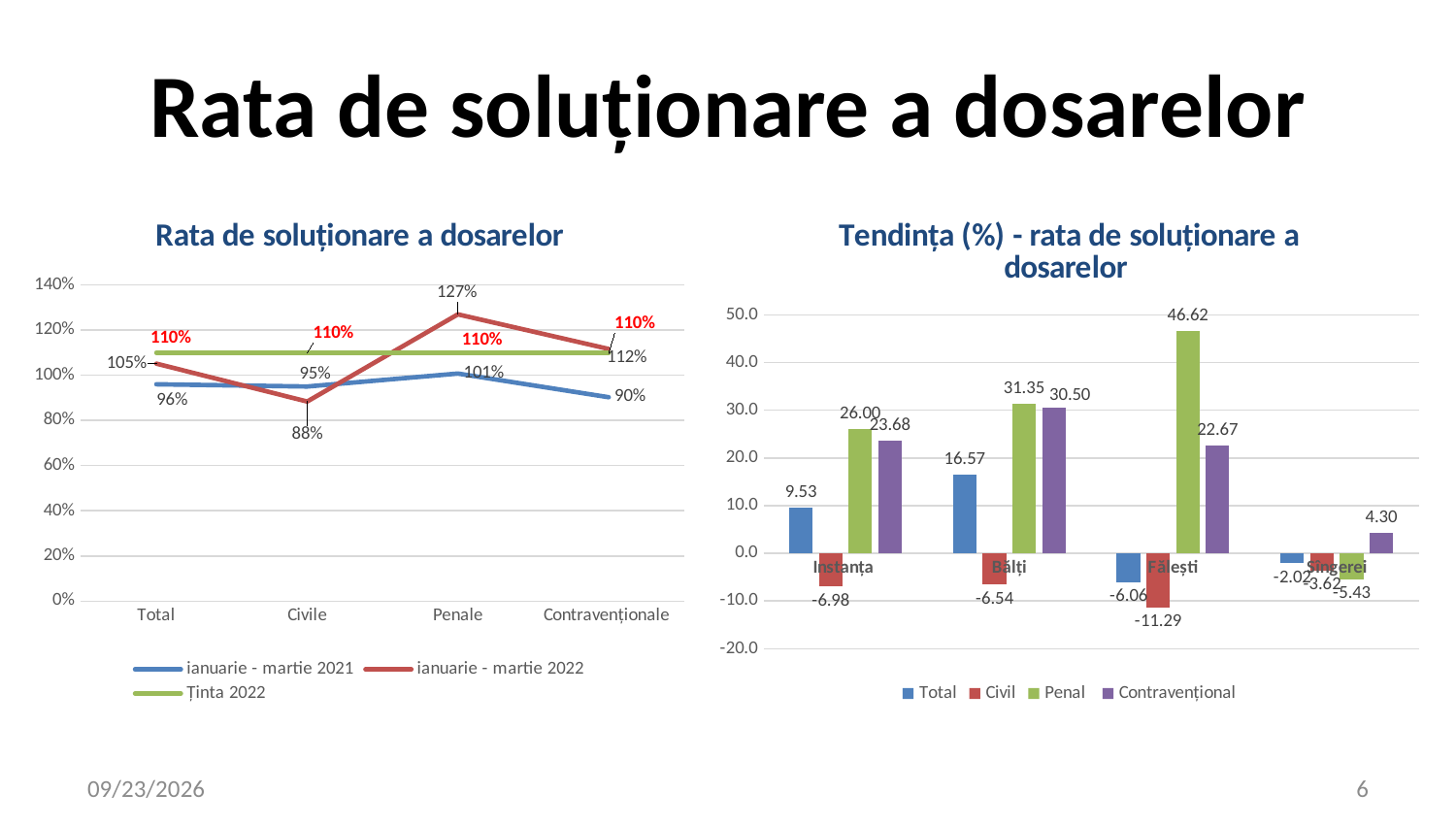
What kind of chart is 'Rata de soluționare a dosarelor'? Line chart In the chart 'Rata de soluționare a dosarelor', what is the value for Penale in the series 'ianuarie - martie 2022'? 127% In the chart 'Tendința (%) - rata de soluționare a dosarelor', which category has the highest Total value? Bălți In the chart 'Rata de soluționare a dosarelor', what is the difference between the 'ianuarie - martie 2022' and 'ianuarie - martie 2021' values for Total? 9% In the chart 'Rata de soluționare a dosarelor', which category has the lowest value in the series 'ianuarie - martie 2022'? Civile In the chart 'Rata de soluționare a dosarelor', how many series does the legend list? 3 What kind of chart is 'Tendința (%) - rata de soluționare a dosarelor'? Bar chart In the chart 'Tendința (%) - rata de soluționare a dosarelor', what is the Civil value for Instanța? -6.98 In the chart 'Tendința (%) - rata de soluționare a dosarelor', how many categories are shown on the x axis? 4 In the chart 'Tendința (%) - rata de soluționare a dosarelor', which is larger for Bălți: the Penal value or the Contravențional value? Penal In the chart 'Rata de soluționare a dosarelor', what is the value for Contravenționale in the series 'ianuarie - martie 2021'? 90% In the chart 'Tendința (%) - rata de soluționare a dosarelor', what is the Penal value for Fălești? 46.62